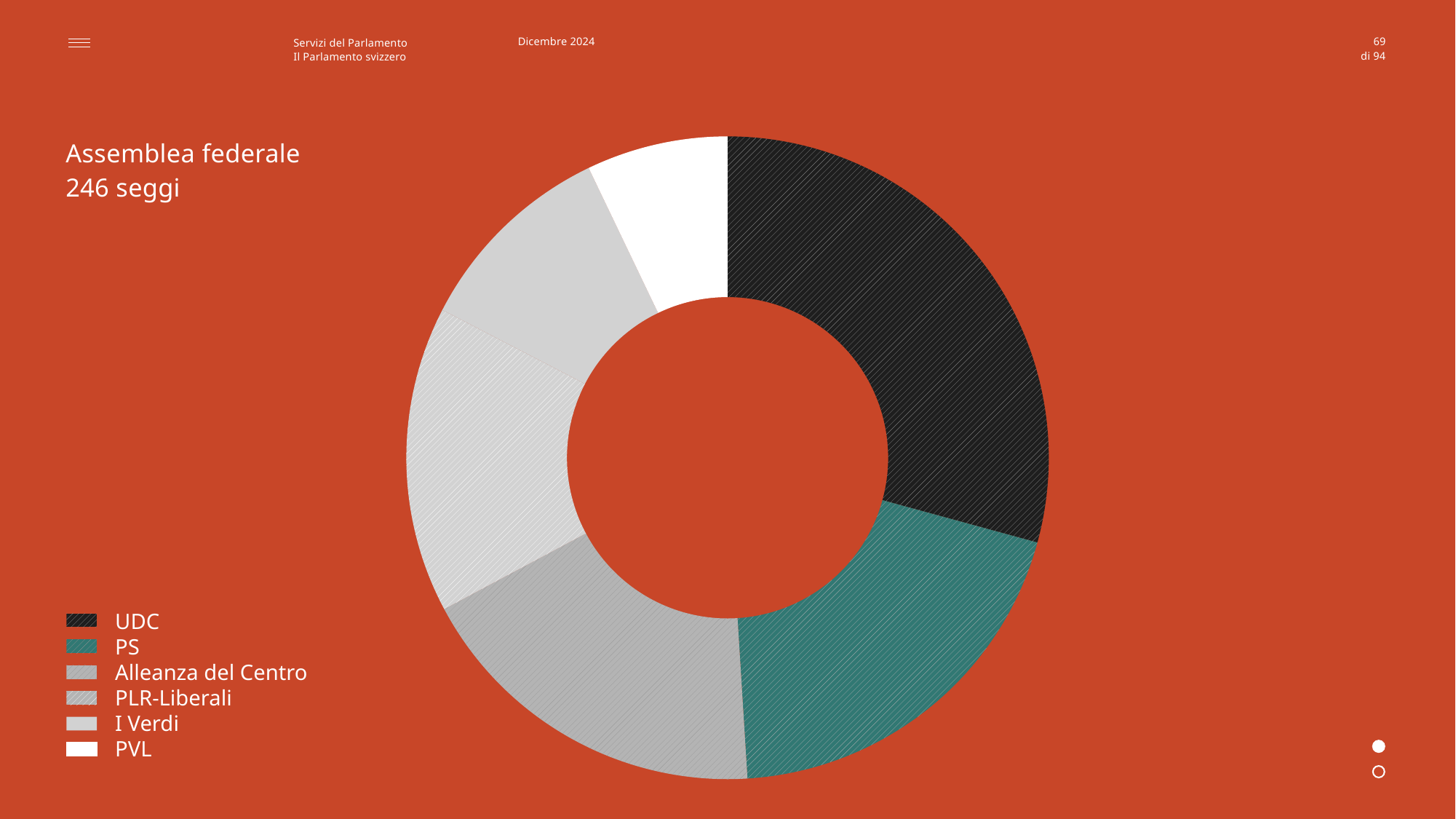
How many seats in total does the chart title say the Assemblea federale has? 246 seggi Which party has the smallest slice of the chart? PVL Which slice is larger, UDC or PS? UDC How many entries does the legend list? 6 What kind of chart is shown on the slide? Pie chart (donut) What is the title of the chart? Assemblea federale 246 seggi Which slice is larger, PS or PVL? PS How many slices does the donut chart have? 6 Which slice is larger, I Verdi or UDC? UDC Which party has the largest slice of the chart? UDC